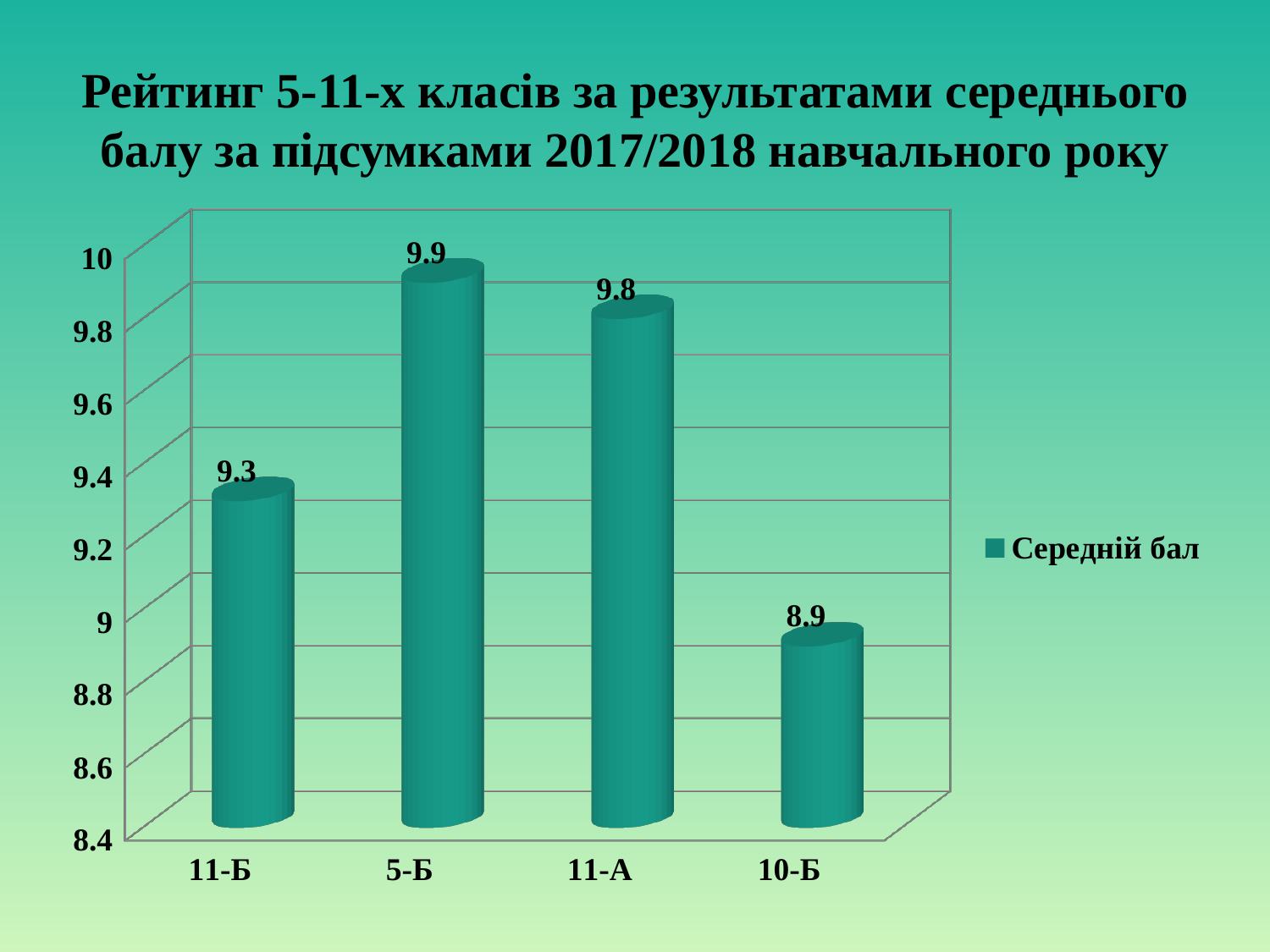
What is the difference between the average scores of 5-Б and 10-Б? 1 What is the average score (Середній бал) for class 11-Б? 9.3 What type of chart is shown on the slide? Bar chart What is the average score for class 11-А? 9.8 What is the average score for class 10-Б? 8.9 What is the difference between the average scores of 11-А and 11-Б? 0.5 Which class has the highest average score? 5-Б Which class has a higher average score, 11-Б or 11-А? 11-А What is the average score for class 5-Б? 9.9 Which class has the lowest average score? 10-Б What series name is listed in the chart legend? Середній бал How many classes are shown on the chart? 4